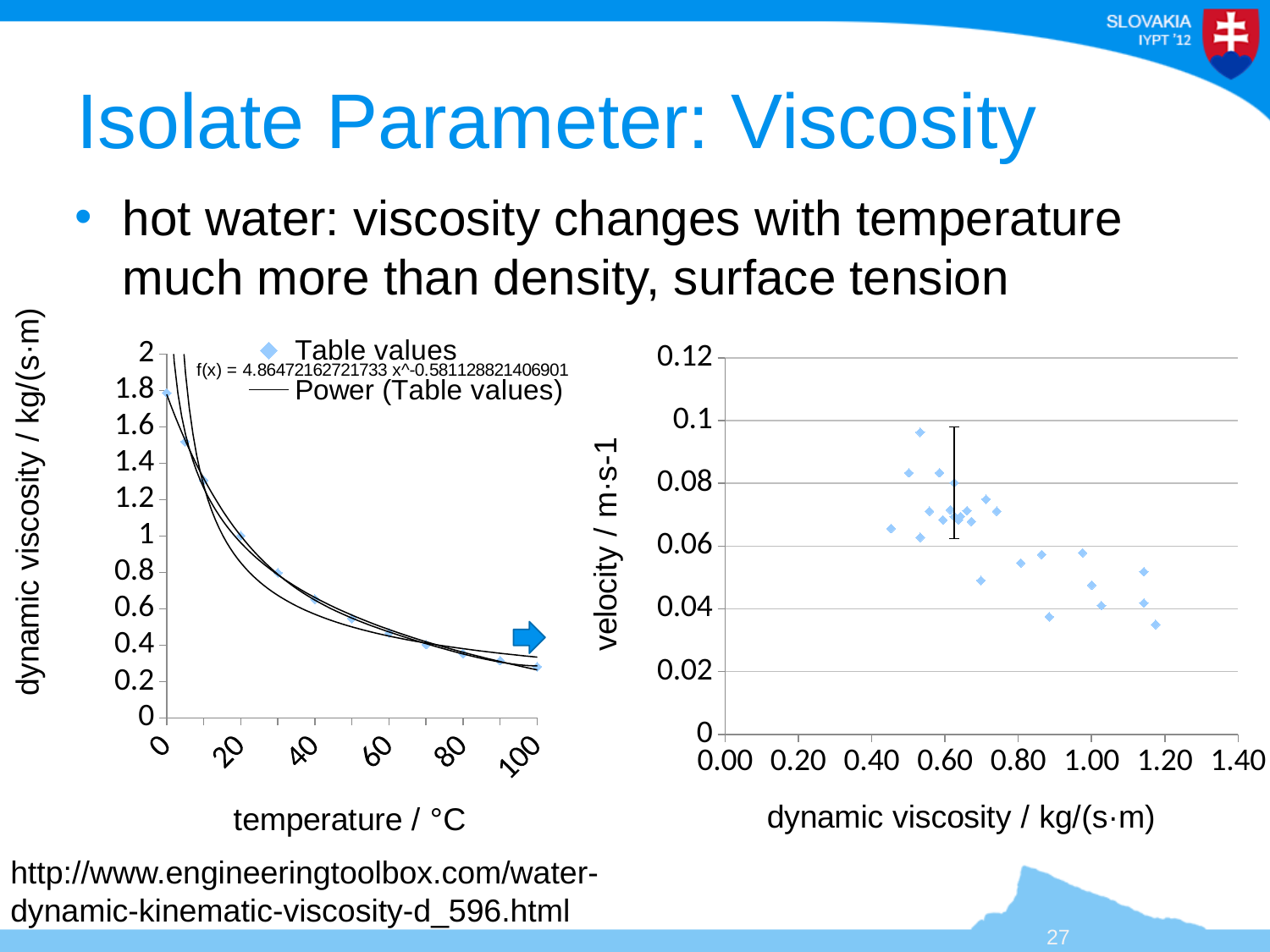
In the right chart, does velocity generally rise or fall as dynamic viscosity increases? fall How many series does the legend of the left chart list? 2 What kind of chart is the right chart (velocity vs dynamic viscosity)? scatter chart In the left chart, is the dynamic viscosity at 40 °C greater or less than 0.8? less What is the y-axis title of the right chart? velocity / m·s-1 In the left chart, is the dynamic viscosity at 0 °C greater or less than 1.6? greater In the left chart, is the dynamic viscosity at 100 °C greater or less than 0.4? less What is the x-axis title of the left chart? temperature / °C What kind of chart is the left chart (dynamic viscosity vs temperature)? scatter chart In the left chart, does dynamic viscosity rise or fall as temperature increases? fall